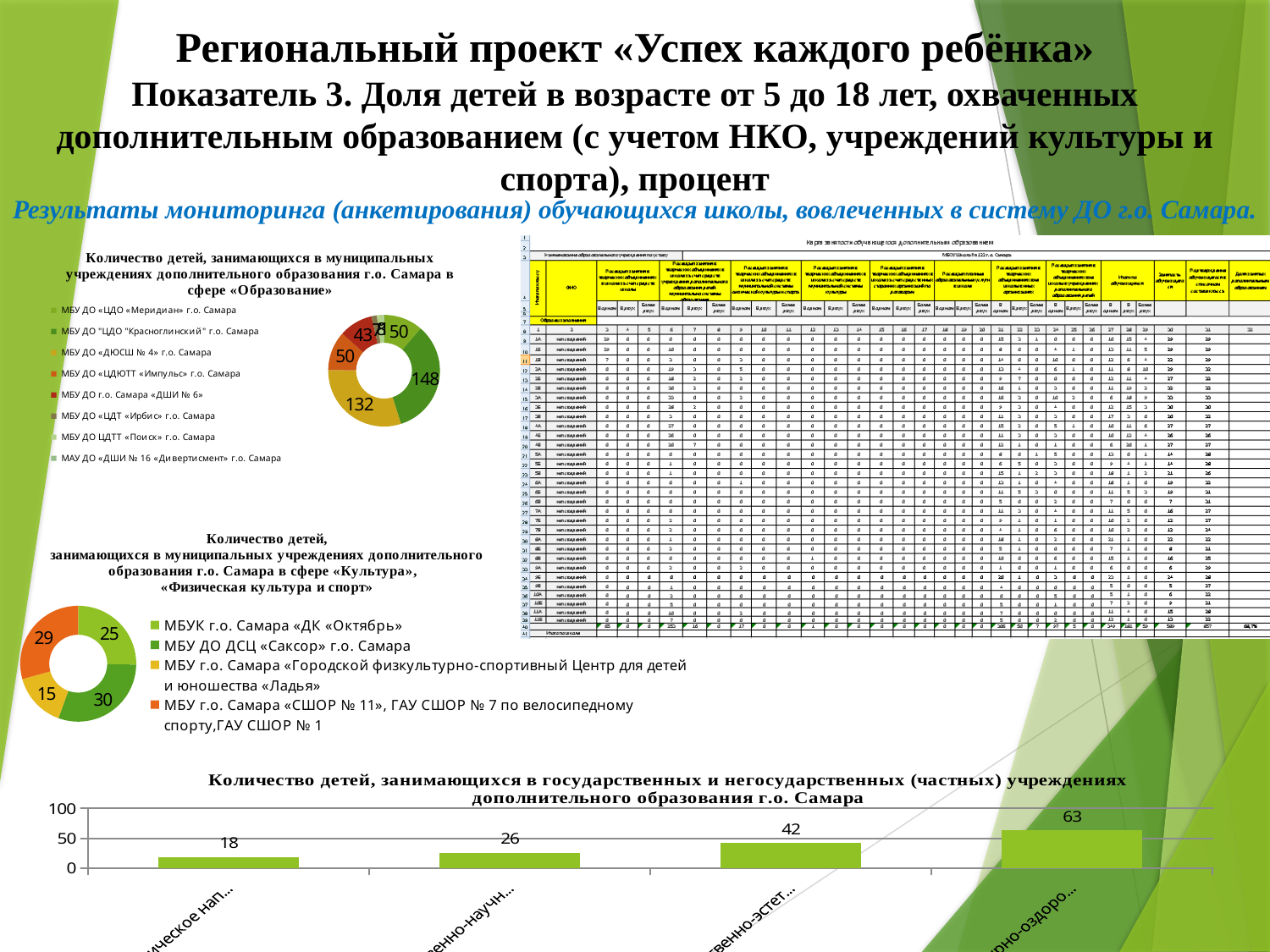
In the doughnut chart about the sphere «Культура», «Физическая культура и спорт», which is larger: the value for МБУК г.о. Самара «ДК «Октябрь» or the value for МБУ ДО ДСЦ «Саксор» г.о. Самара? МБУ ДО ДСЦ «Саксор» г.о. Самара In the bar chart at the bottom of the slide, what is the difference between the fourth bar (63) and the third bar (42)? 21 In the doughnut chart about the sphere «Культура», «Физическая культура и спорт», what is the value for МБУ ДО ДСЦ «Саксор» г.о. Самара? 30 In the bar chart at the bottom of the slide, do the values rise or fall from left to right? rise In the bar chart at the bottom of the slide, what is the value of the tallest bar? 63 In the bar chart at the bottom of the slide, how many bars are plotted? 4 In the doughnut chart about the sphere «Образование» at the top left, what is the largest value shown on a slice? 148 In the doughnut chart about the sphere «Культура», «Физическая культура и спорт», what is the value for МБУ г.о. Самара «Городской физкультурно-спортивный Центр для детей и юношества «Ладья»? 15 How many entries does the legend of the doughnut chart about the sphere «Образование» at the top left list? 8 In the bar chart at the bottom of the slide, is the value of the fourth bar greater or less than 50? greater In the bar chart at the bottom of the slide, what is the value of the shortest bar? 18 What kind of chart is the chart titled «Количество детей, занимающихся в государственных и негосударственных (частных) учреждениях дополнительного образования г.о. Самара» at the bottom of the slide? bar chart